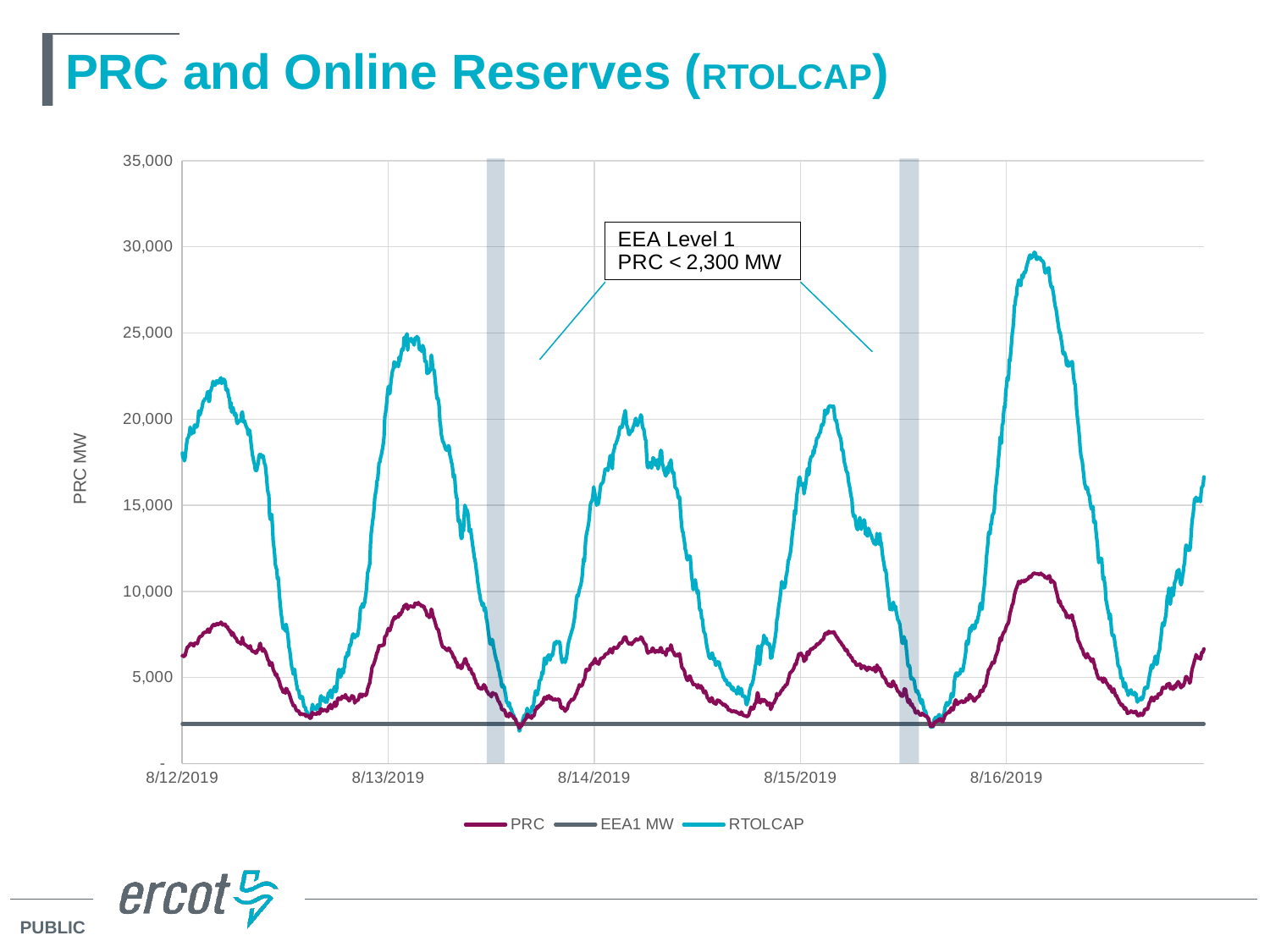
What is the label on the vertical axis of the chart? PRC MW Is the peak value of PRC on 8/13/2019 greater or less than 10,000? less Does the EEA1 MW line rise, fall, or stay flat across the x axis? Stays flat Which series is higher throughout the chart, PRC or RTOLCAP? RTOLCAP What are the three series named in the legend? PRC, EEA1 MW, RTOLCAP What kind of chart is shown on the slide? Line chart On which date does RTOLCAP reach its highest peak? 8/16/2019 Is the peak value of PRC on 8/16/2019 greater or less than 10,000? greater How many dates are labelled on the horizontal axis? 5 Is the peak value of RTOLCAP on 8/12/2019 greater or less than 20,000? greater On which date does PRC reach its highest peak? 8/16/2019 How many series does the legend list? 3